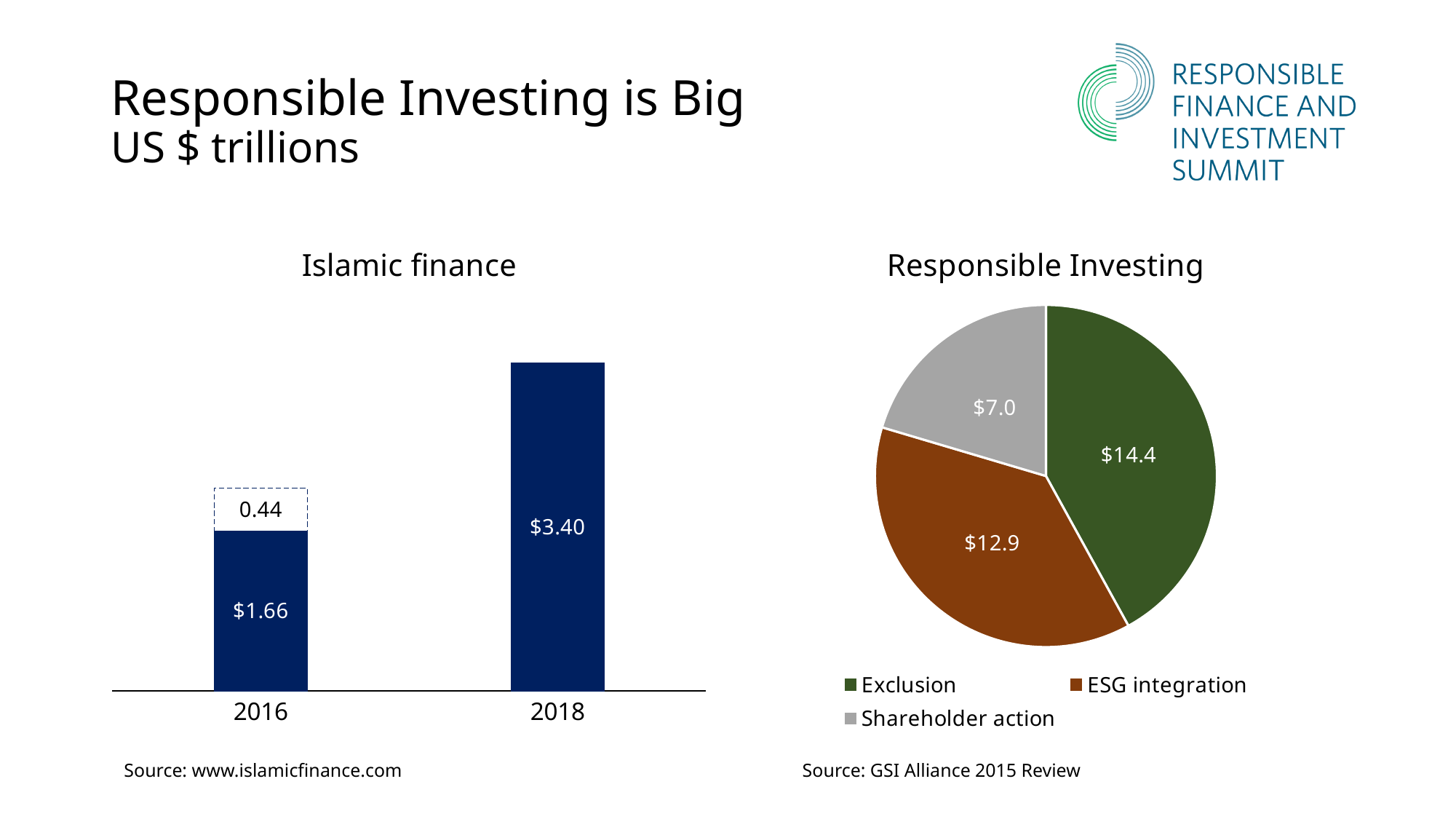
In the Responsible Investing pie chart, what is the value for ESG integration? $12.9 In the Islamic finance bar chart, what is the value labelled inside the solid 2016 bar? $1.66 In the Responsible Investing pie chart, what is the difference between Exclusion and ESG integration? $1.5 In the Responsible Investing pie chart, which category has the smallest value? Shareholder action How many categories does the legend of the Responsible Investing pie chart list? 3 What kind of chart is the Islamic finance chart? bar chart In the Islamic finance bar chart, what is the value for 2018? $3.40 In the Islamic finance bar chart, do the values rise or fall from 2016 to 2018? rise In the Islamic finance bar chart, what value is shown in the dashed box above the 2016 bar? 0.44 In the Islamic finance bar chart, what is the difference between the 2018 value and the solid 2016 value ($3.40 and $1.66)? $1.74 In the Responsible Investing pie chart, which category has the largest value? Exclusion In the Responsible Investing pie chart, what colour is the Shareholder action slice? grey